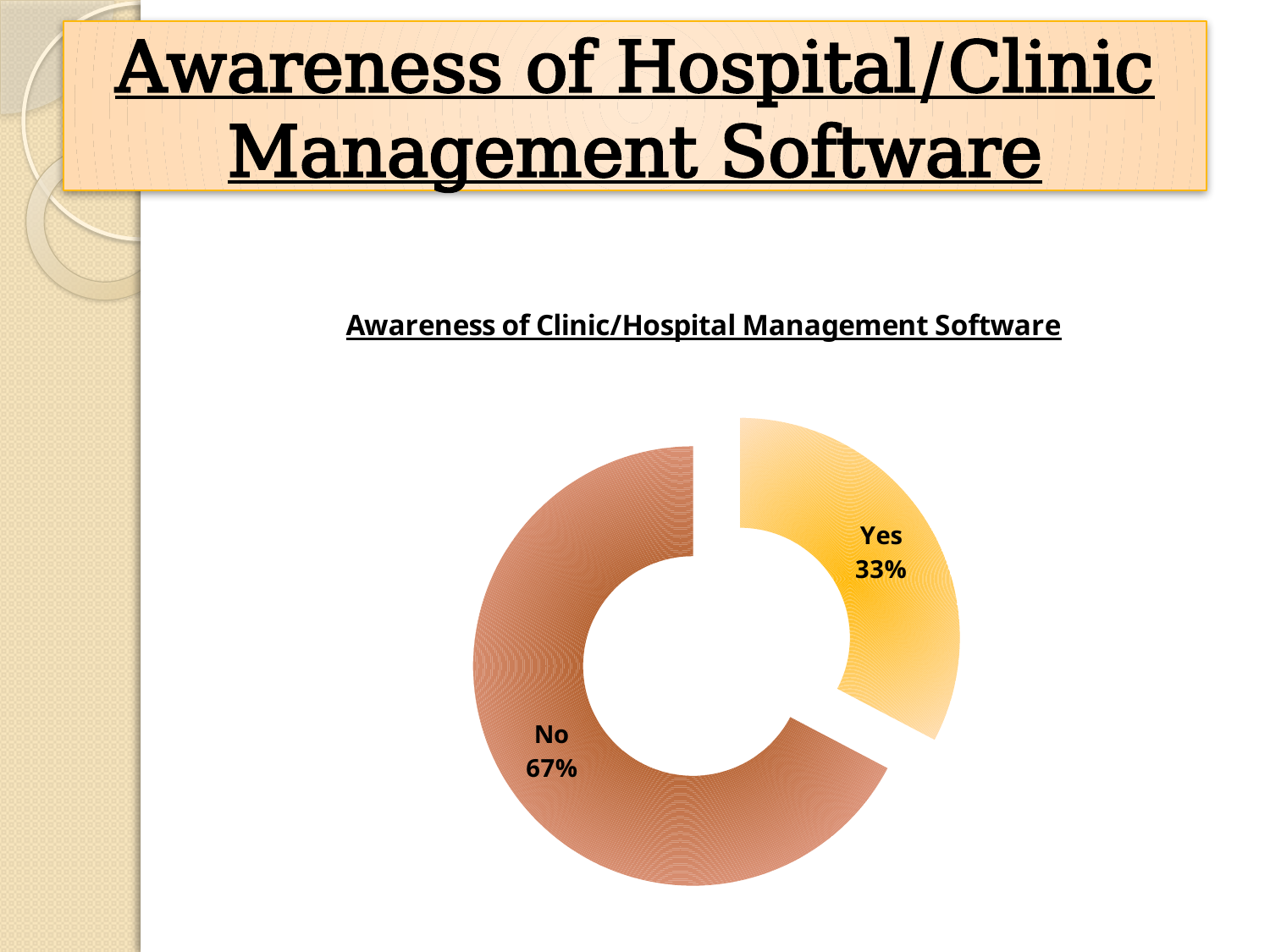
What percentage of respondents answered "Yes" in the Awareness of Clinic/Hospital Management Software chart? 33% Which category has the smallest share in the chart? Yes What kind of chart is shown on the slide? Doughnut (pie) chart What percentage of respondents answered "No" in the Awareness of Clinic/Hospital Management Software chart? 67% Which category has the largest share in the chart? No What share of the chart does the "Yes" slice represent? 33% Which is larger, the share for "Yes" or the share for "No"? No How many categories are shown in the chart? 2 What is the difference in percentage points between the "No" and "Yes" shares? 34 What colour is the "No" segment of the chart? Brown What is the title of the chart? Awareness of Clinic/Hospital Management Software